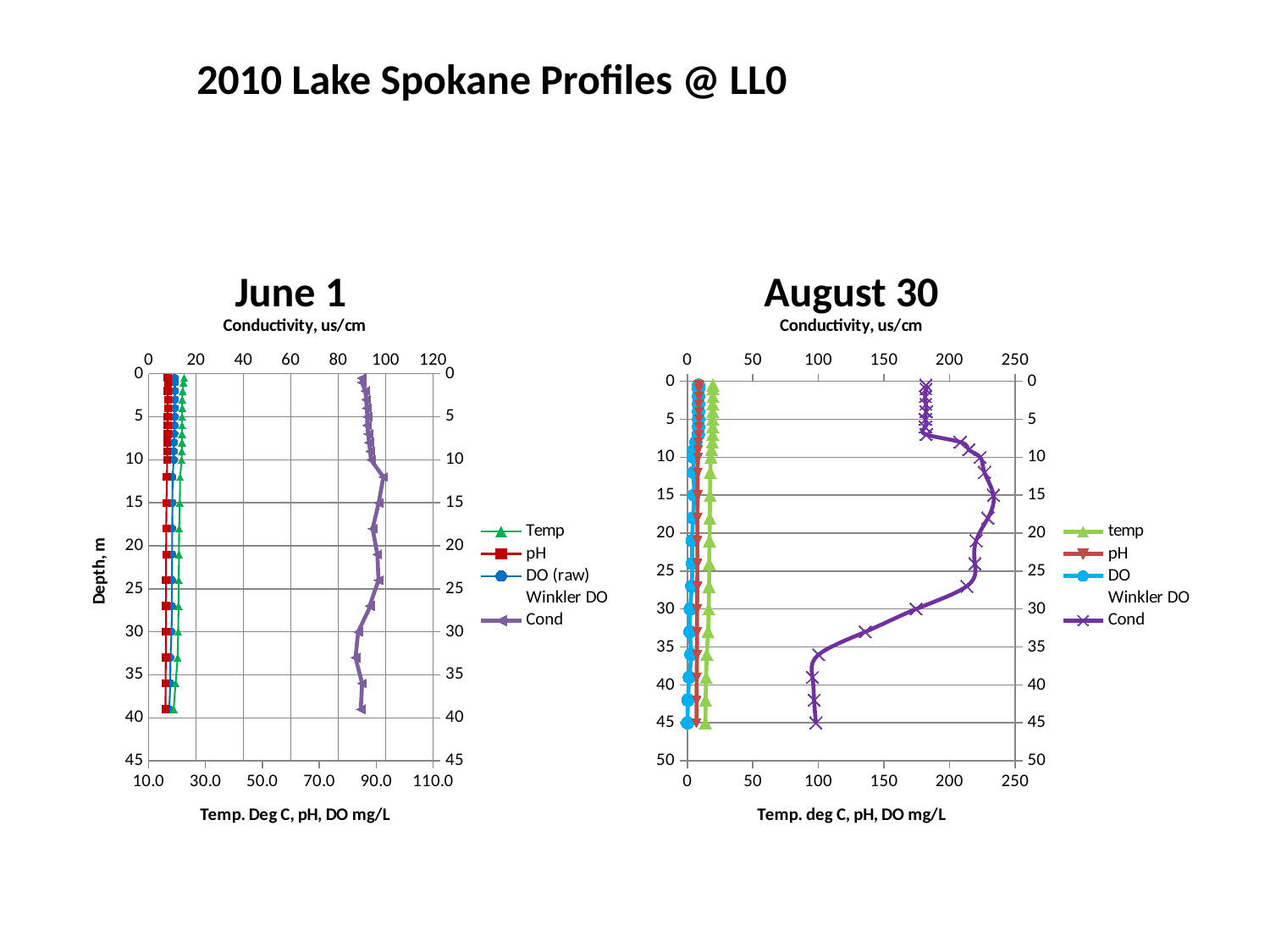
In the August 30 chart, does the Cond value increase or decrease as depth goes from 25 m to 35 m? decrease In the August 30 chart, does the Cond value increase or decrease as depth goes from 5 m to 15 m? increase How many series does the legend of the June 1 chart list? 5 In the August 30 chart, which is larger: the Cond value at 15 m depth or the Cond value at 45 m depth? Cond at 15 m depth What is the title of the slide? 2010 Lake Spokane Profiles @ LL0 In the August 30 chart, is the temp value at a depth of 0 m greater or less than 50? less In the June 1 chart, is the Cond value at a depth of 0 m greater or less than 80? greater In the August 30 chart, is the Cond value at a depth of 45 m greater or less than 150? less How many series does the legend of the August 30 chart list? 5 What is the label of the top horizontal axis on the June 1 chart? Conductivity, us/cm What kind of chart is the June 1 chart? line chart